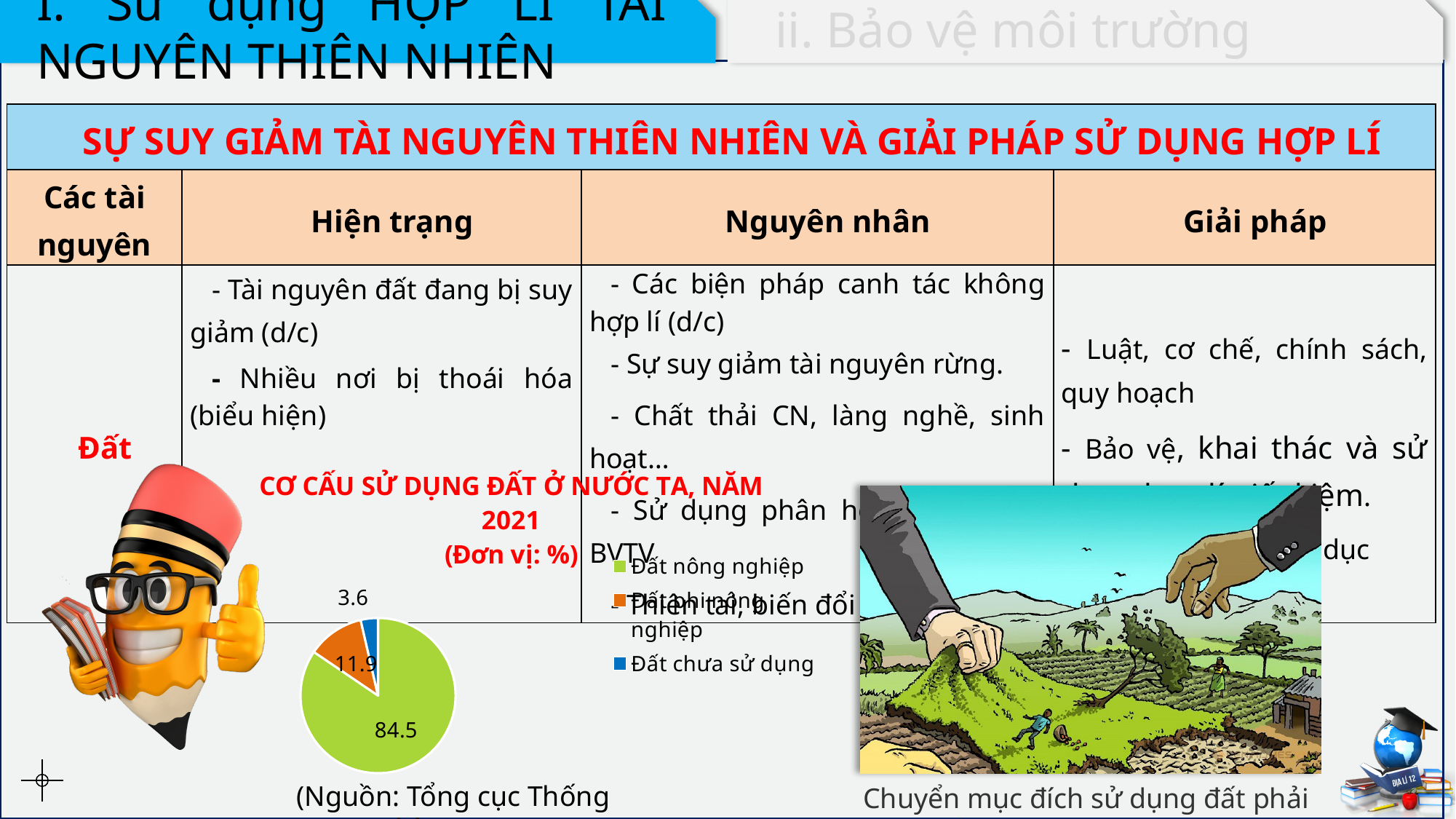
Which category has the smallest share in the pie chart? Đất chưa sử dụng Which is larger in the pie chart: the orange slice or Đất chưa sử dụng? The orange slice What is the value for Đất chưa sử dụng in the pie chart? 3.6 What is the value of the orange slice in the pie chart? 11.9 What unit is stated for the pie chart? % What is the value for Đất nông nghiệp in the pie chart? 84.5 How many entries does the pie chart legend list? 3 What kind of chart is shown on the slide? Pie chart How many slices does the pie chart have? 3 Which category has the largest share in the pie chart? Đất nông nghiệp What is the title of the pie chart? CƠ CẤU SỬ DỤNG ĐẤT Ở NƯỚC TA, NĂM 2021 What is the difference between the value for Đất nông nghiệp and the value for Đất chưa sử dụng? 80.9